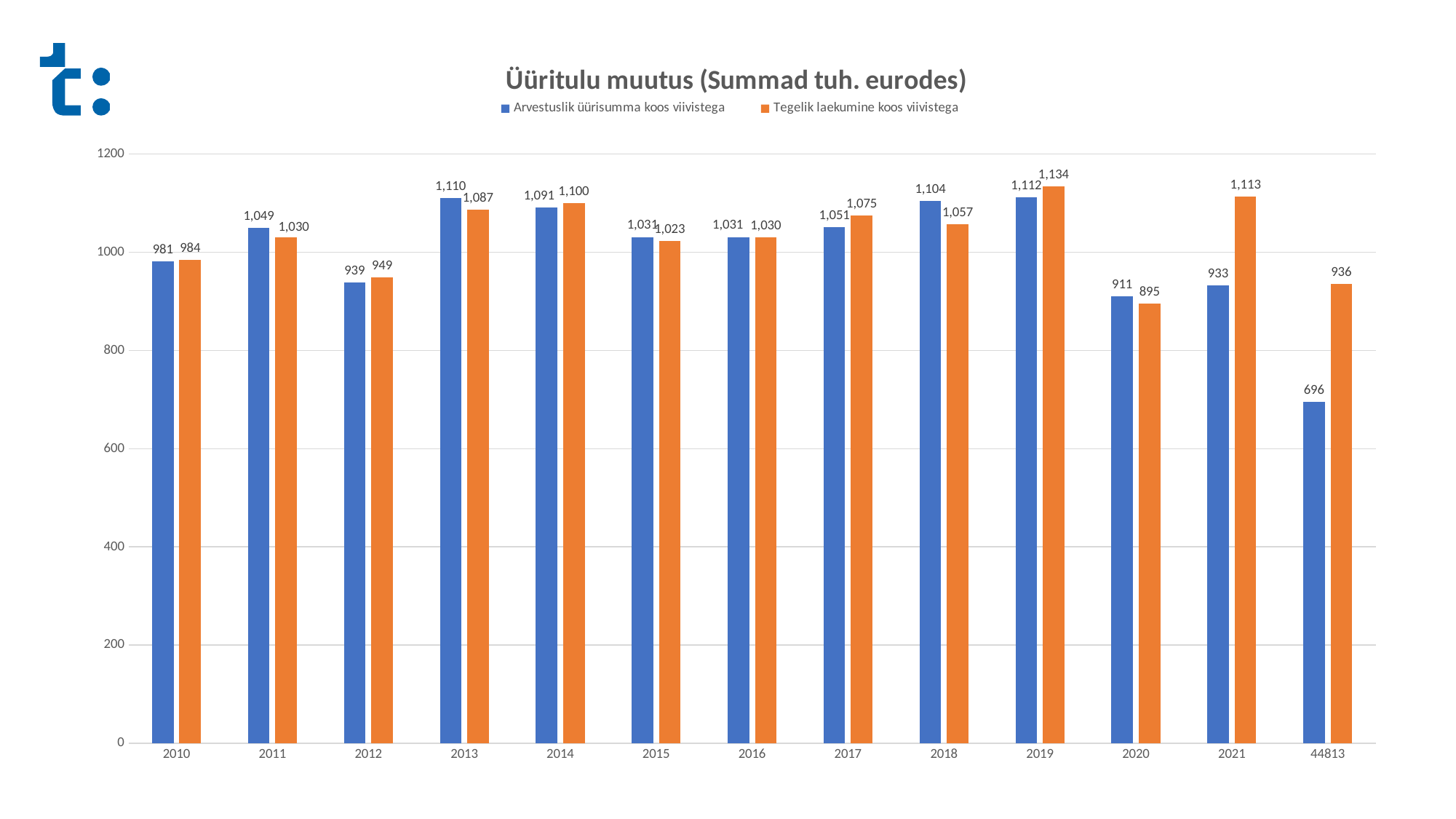
What is the title of the chart? Üüritulu muutus (Summad tuh. eurodes) Which category has the lowest value for Arvestuslik üürisumma koos viivistega? 44813 What is the value of Arvestuslik üürisumma koos viivistega for 2013? 1,110 What kind of chart is shown on the slide? bar chart What is the value of Arvestuslik üürisumma koos viivistega for the category labelled 44813? 696 How many categories are shown on the x axis? 13 Is the value of Tegelik laekumine koos viivistega for 2012 greater or less than 1000? less What is the difference between Arvestuslik üürisumma koos viivistega and Tegelik laekumine koos viivistega in 2021? 180 In 2020, which is larger: Arvestuslik üürisumma koos viivistega or Tegelik laekumine koos viivistega? Arvestuslik üürisumma koos viivistega What is the value of Tegelik laekumine koos viivistega for 2019? 1,134 Which category has the highest value for Tegelik laekumine koos viivistega? 2019 How many series does the legend list? 2